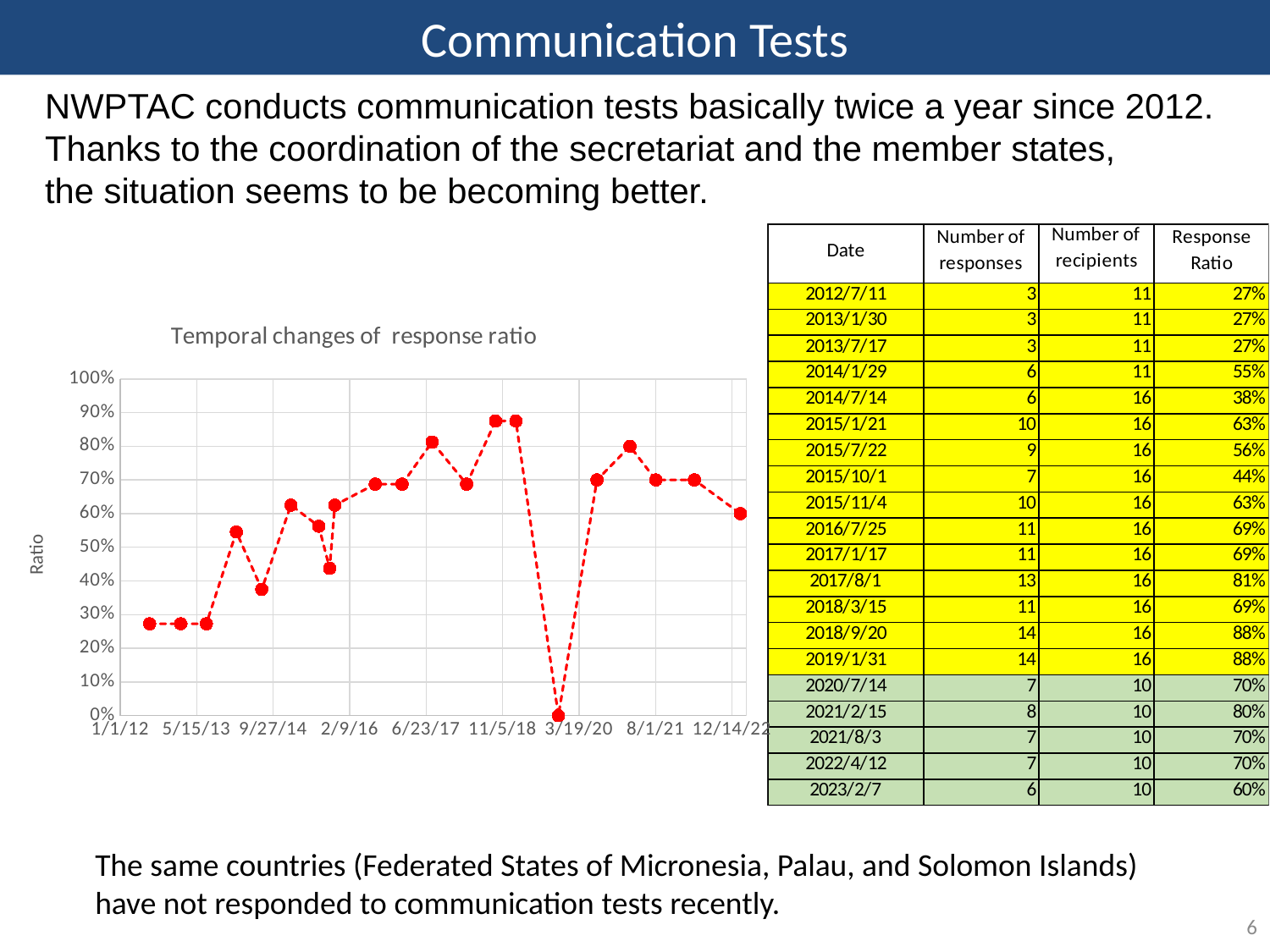
What label is shown on the vertical axis of the chart? Ratio What is the value of the last plotted point on the chart? 60% Which is larger, the first plotted value or the last plotted value? the last plotted value Is the highest plotted value on the chart greater or less than 80%? greater Is the value plotted near 11/5/18 greater or less than 80%? greater Do the plotted values generally rise or fall from the start of the series to the end? rise Is the first plotted value (at 1/1/12) greater or less than 30%? less What is the title of the chart? Temporal changes of response ratio What is the lowest value plotted on the chart? 0% What kind of chart is shown on the slide? line chart